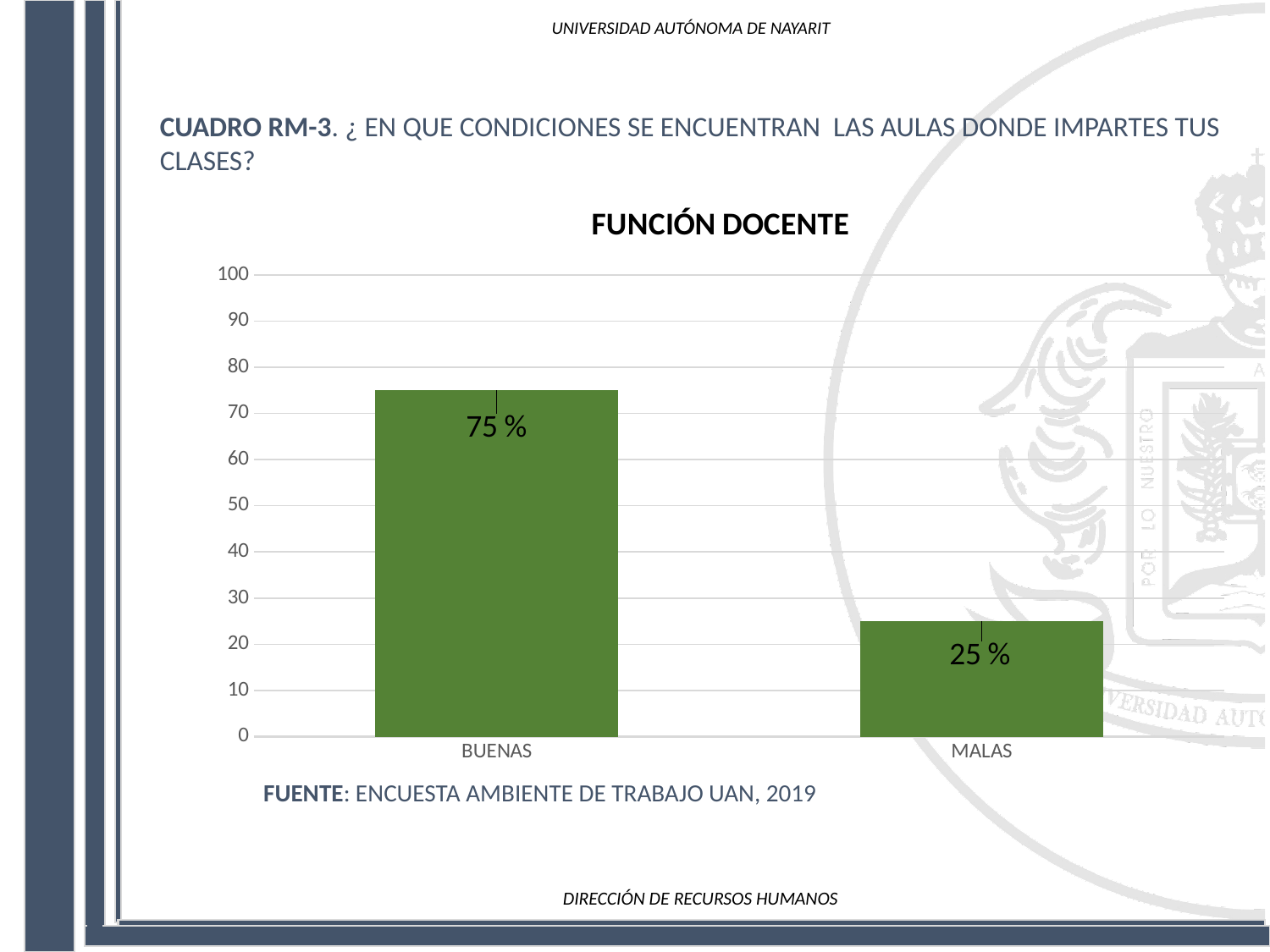
Which category has the lowest value? MALAS Which category has the highest value? BUENAS What is the difference between the values for BUENAS and MALAS? 50 % How many categories are shown on the x axis? 2 What is the title of the chart? FUNCIÓN DOCENTE What colour are the bars in the chart? green Is the value for MALAS greater or less than 30? less What is the value for MALAS? 25 % Which is larger, the value for BUENAS or the value for MALAS? BUENAS What is the value for BUENAS? 75 % What kind of chart is shown on the slide? bar chart Is the value for BUENAS greater or less than 70? greater